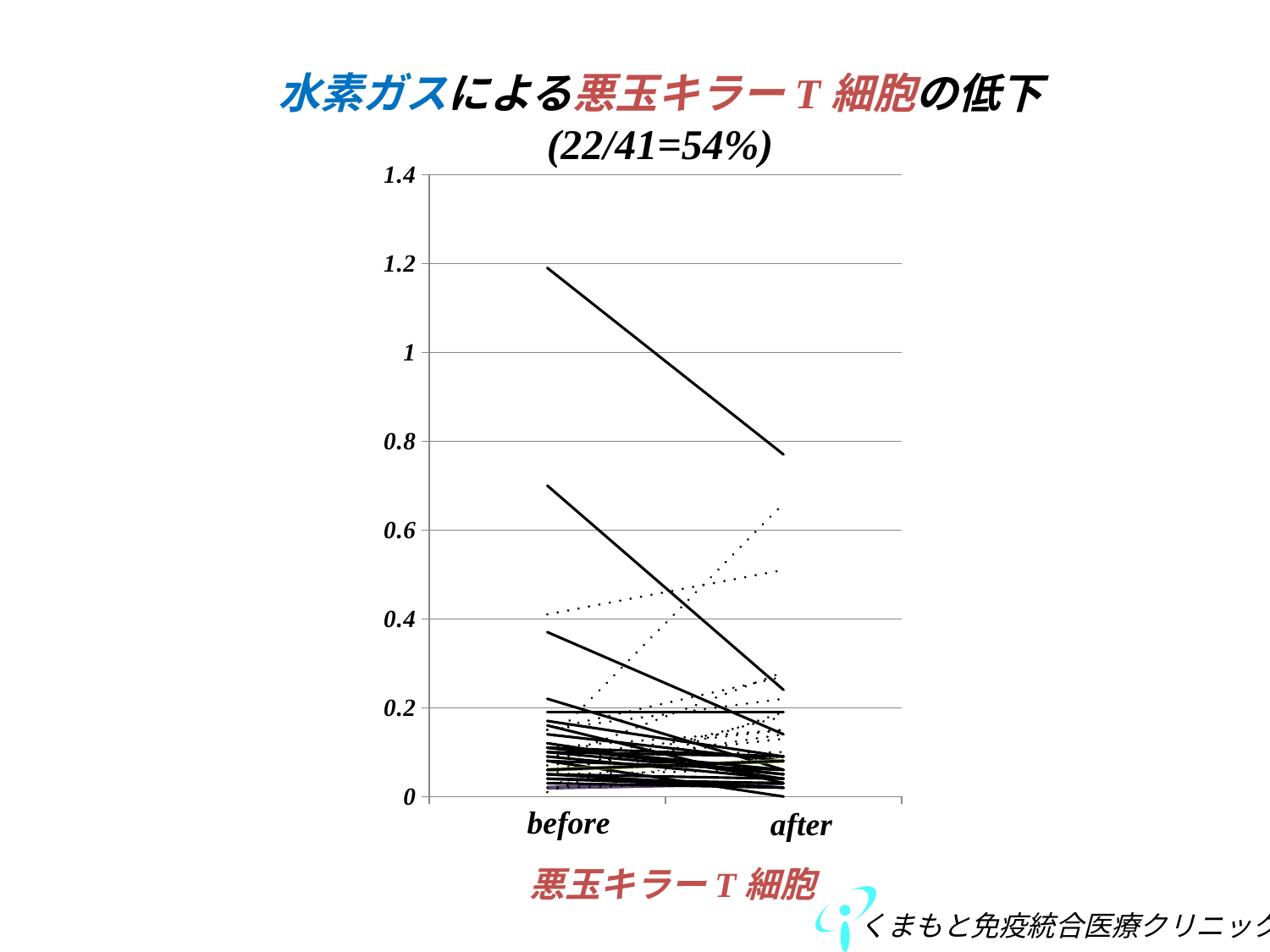
Does the topmost line in the chart rise or fall from 'before' to 'after'? fall How many categories are shown on the x axis of the chart? 2 What kind of chart is shown on the slide? line chart Is the highest value at 'after' greater or less than 0.6? greater What are the two categories on the x axis of the chart? before, after What is the title of the chart? 水素ガスによる悪玉キラーT 細胞の低下 (22/41=54%) What is the highest tick value shown on the y axis of the chart? 1.4 Is the 'after' value of the solid line that starts near 0.7 at 'before' greater or less than 0.4? less Is the second-highest 'before' value (the solid line starting near 0.7) greater or less than 0.6? greater For the topmost line in the chart, which is larger, the value at 'before' or the value at 'after'? before